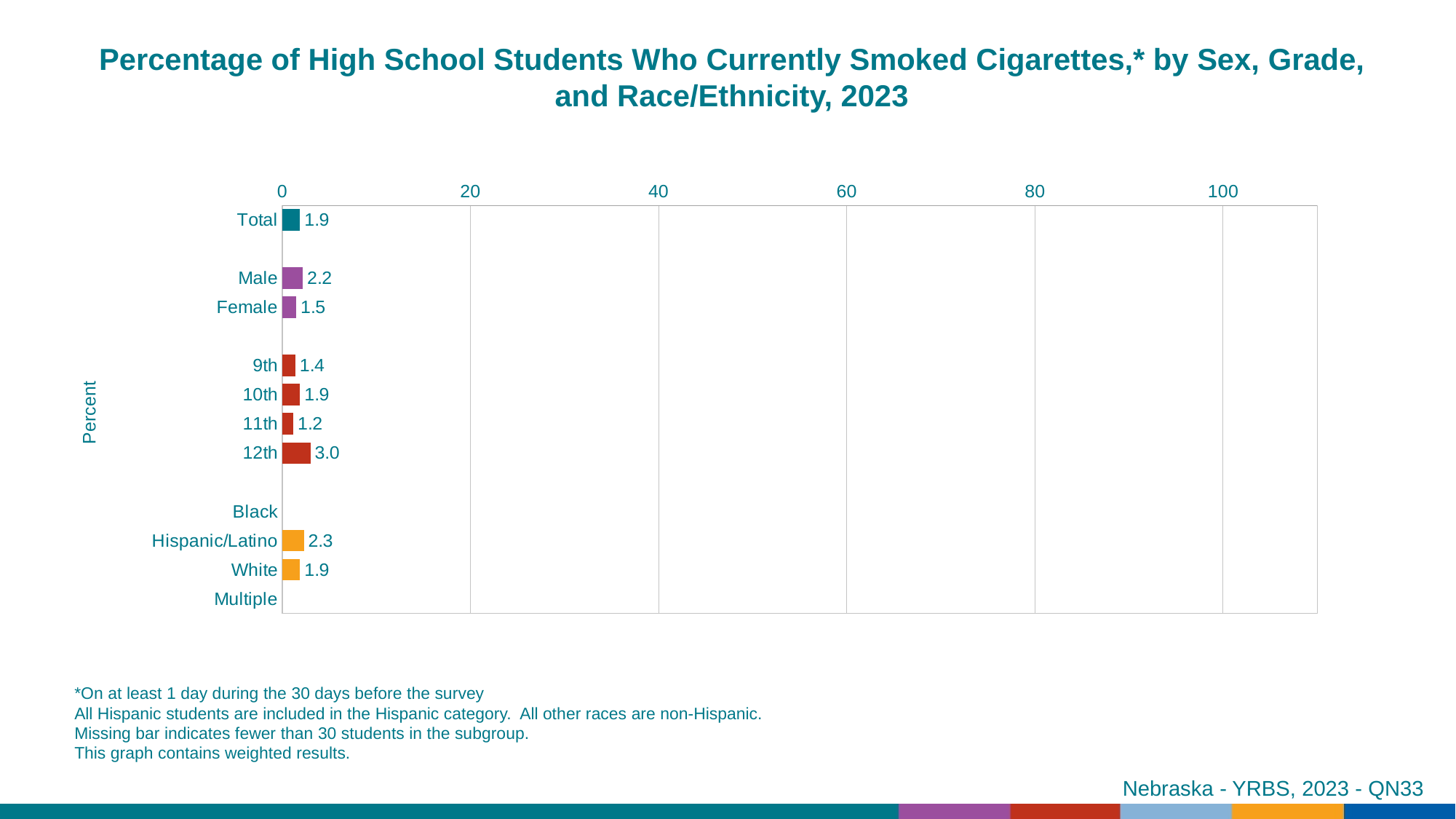
Which grade has the highest value? 12th Which is larger, the value for 9th grade or the value for 10th grade? 10th What is the value for 12th grade? 3.0 How many categories have a bar plotted? 9 What is the value for Hispanic/Latino? 2.3 What is the value for Male? 2.2 Which race/ethnicity categories have no bar shown? Black and Multiple Which grade has the lowest value? 11th Is the value for 12th grade greater or less than 20? less What is the value for Total? 1.9 What is the difference between the Male and Female values? 0.7 What kind of chart is shown? bar chart